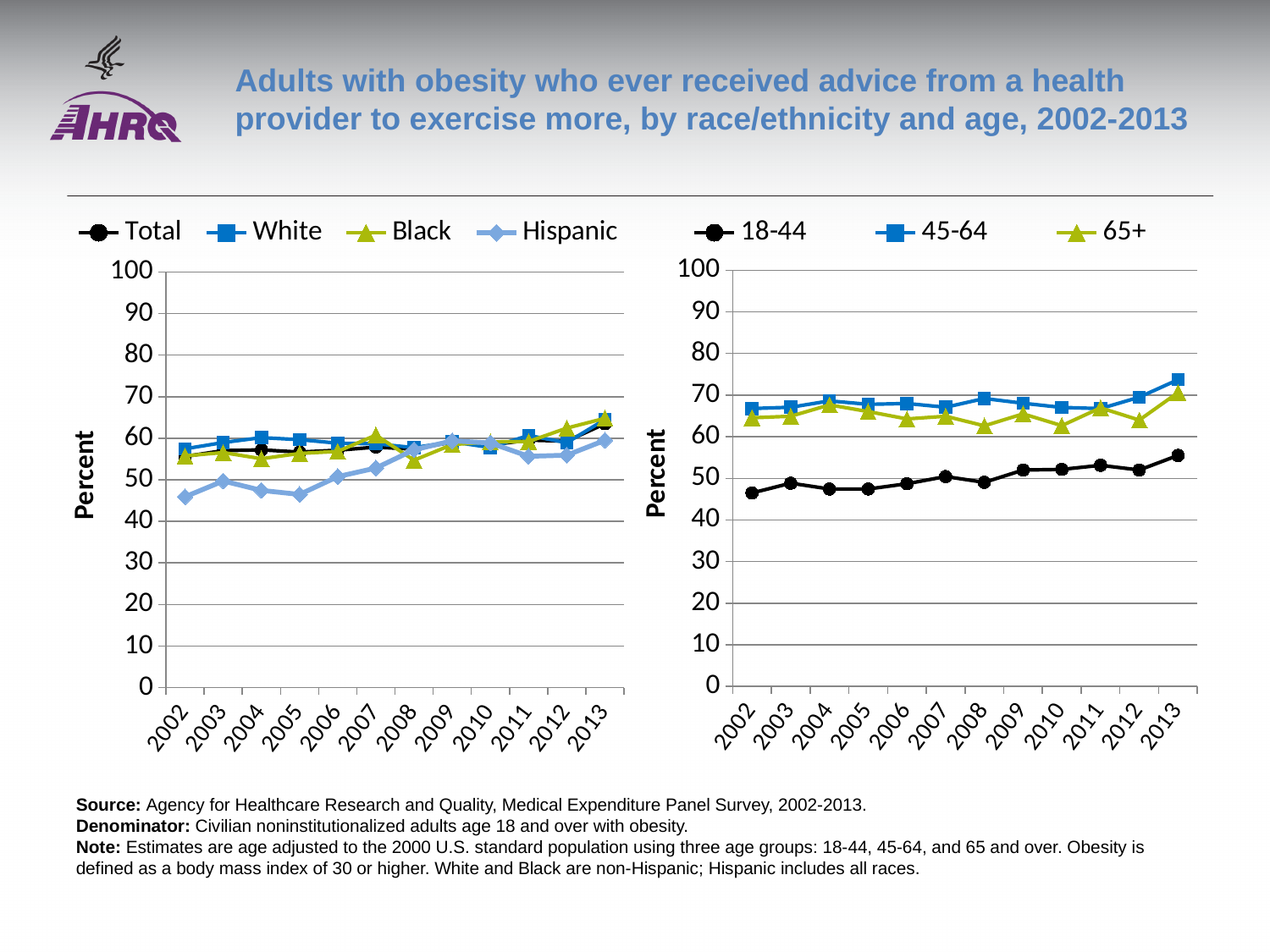
What is the y-axis label on the left chart (by race/ethnicity)? Percent How many series does the legend of the right chart (by age) list? 3 In the left chart (by race/ethnicity), which group had the lowest value in 2002? Hispanic In the right chart (by age), which is larger in 2002: the value for 45-64 or the value for 18-44? 45-64 In the left chart (by race/ethnicity), is the value for Hispanic in 2002 greater or less than 50? less In the right chart (by age), is the value for 45-64 in 2013 greater or less than 70? greater In the right chart (by age), which age group had the highest value in 2013? 45-64 How many years are plotted along the x axis of the right chart (by age)? 12 In the right chart (by age), is the value for 18-44 in 2002 greater or less than 50? less What kind of chart is the left chart (by race/ethnicity)? Line chart How many series does the legend of the left chart (by race/ethnicity) list? 4 In the right chart (by age), does the value for 18-44 generally rise or fall from 2002 to 2013? Rise